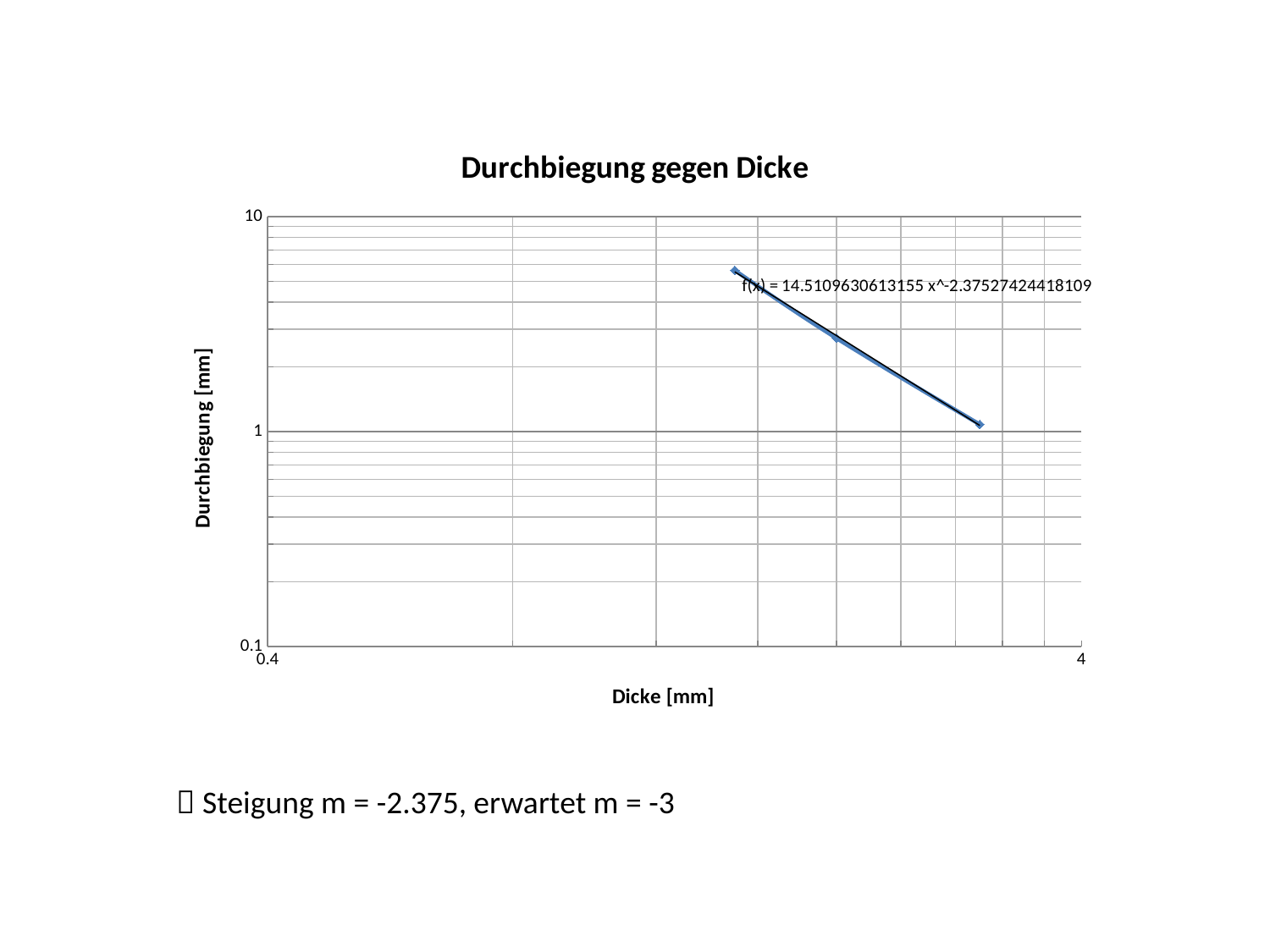
Is the Durchbiegung value of the leftmost data point greater or less than 10? less Do the plotted values rise or fall as Dicke increases along the x axis? Fall What is the coefficient in the trendline equation f(x) shown on the chart? 14.5109630613155 What kind of chart is shown on the slide? Scatter chart with a trendline What is the label of the x axis? Dicke [mm] How many data points are plotted in the chart? 3 What is the highest value shown on the y axis? 10 Which data point has the highest Durchbiegung value, the leftmost or the rightmost? The leftmost Is the Durchbiegung value of the leftmost data point greater or less than 1? greater What is the lowest value shown on the x axis? 0.4 What is the title of the chart? Durchbiegung gegen Dicke What is the exponent of x in the trendline equation shown on the chart? -2.37527424418109